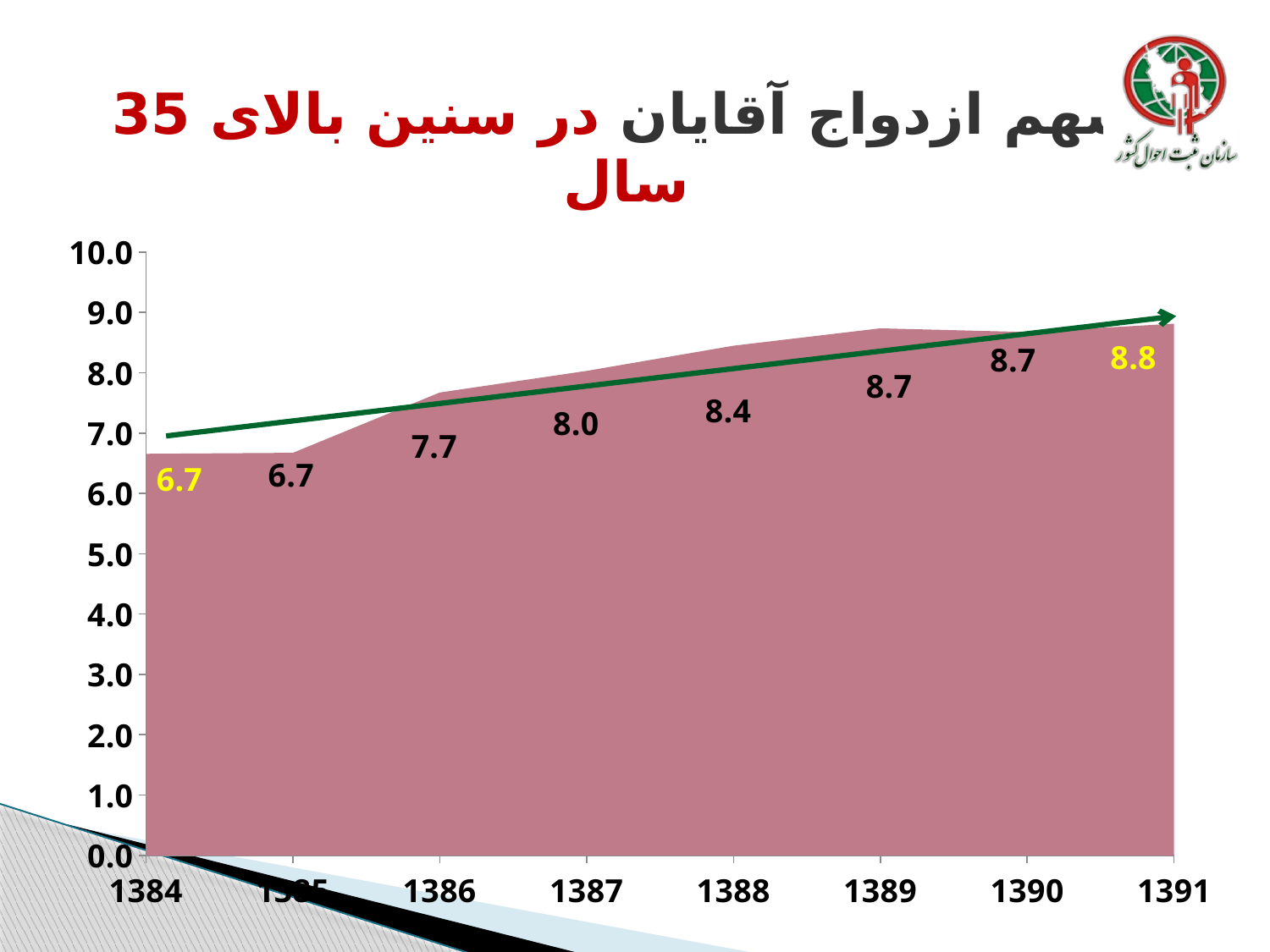
What kind of chart is shown? Area chart What is the difference between the values for 1391 and 1384? 2.1 What is the value for 1391? 8.8 Is the value for 1390 greater or less than 8.0? greater Which is larger, the value for 1388 or the value for 1386? 1388 What is the lowest value shown on the chart? 6.7 Do the values rise or fall from 1384 to 1391? Rise How many years are plotted on the x axis? 8 What is the value for 1389? 8.7 What is the value for 1387? 8.0 Which year has the highest value? 1391 What is the value for 1384? 6.7